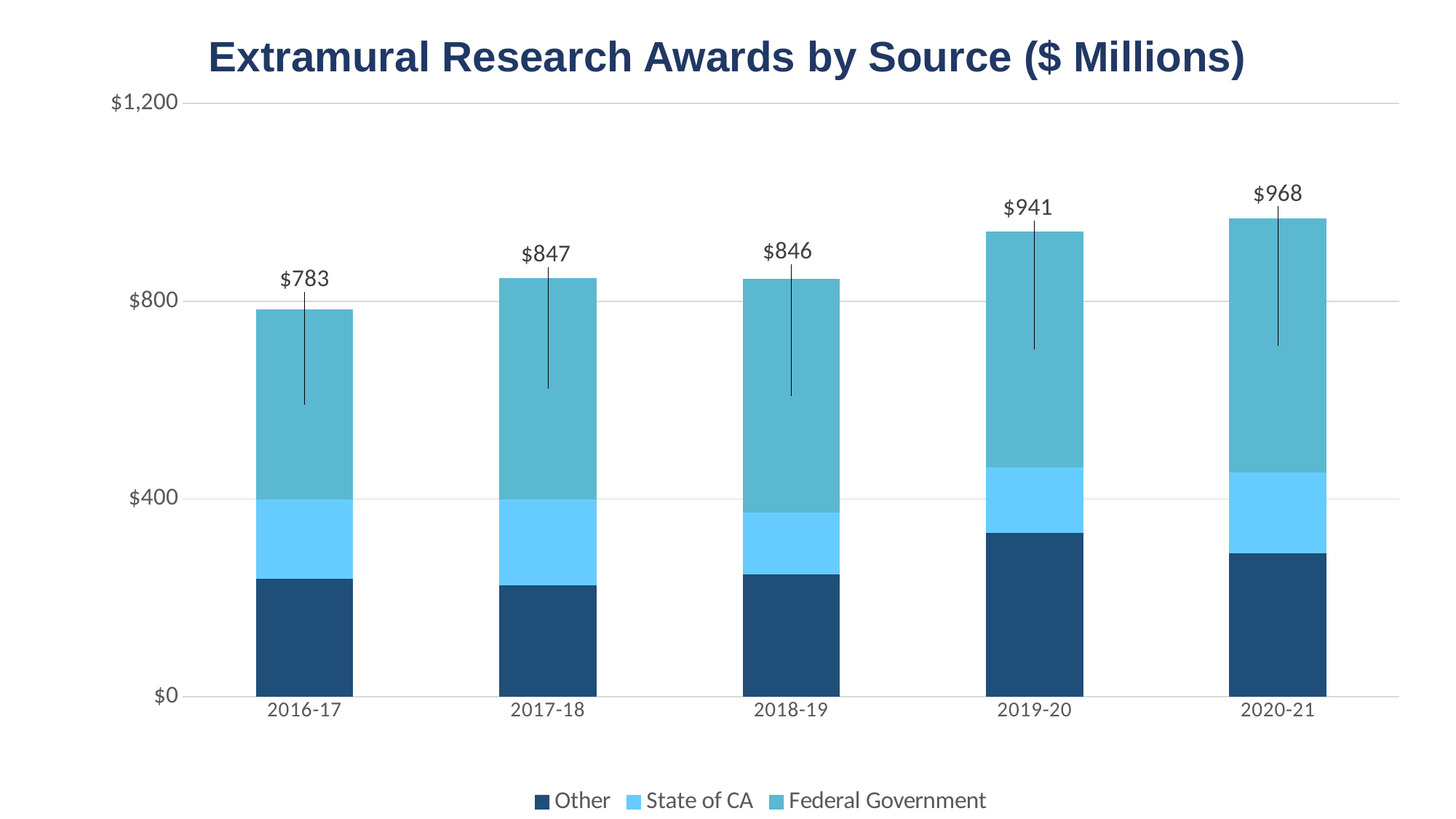
What kind of chart is shown on the slide? Stacked bar chart What is the total extramural research award value shown for 2016-17? $783 Which year has the highest total extramural research awards? 2020-21 What is the difference between the 2020-21 total and the 2016-17 total? $185 What is the difference between the 2019-20 total and the 2017-18 total? $94 Is the value of the Other segment for 2019-20 greater or less than 400? less What is the total value labeled on the 2019-20 bar? $941 Which year has the lowest total extramural research awards? 2016-17 What is the total value labeled on the 2020-21 bar? $968 How many fiscal years are shown on the x axis? 5 Which total is larger, 2019-20 or 2018-19? 2019-20 How many series does the legend list? 3